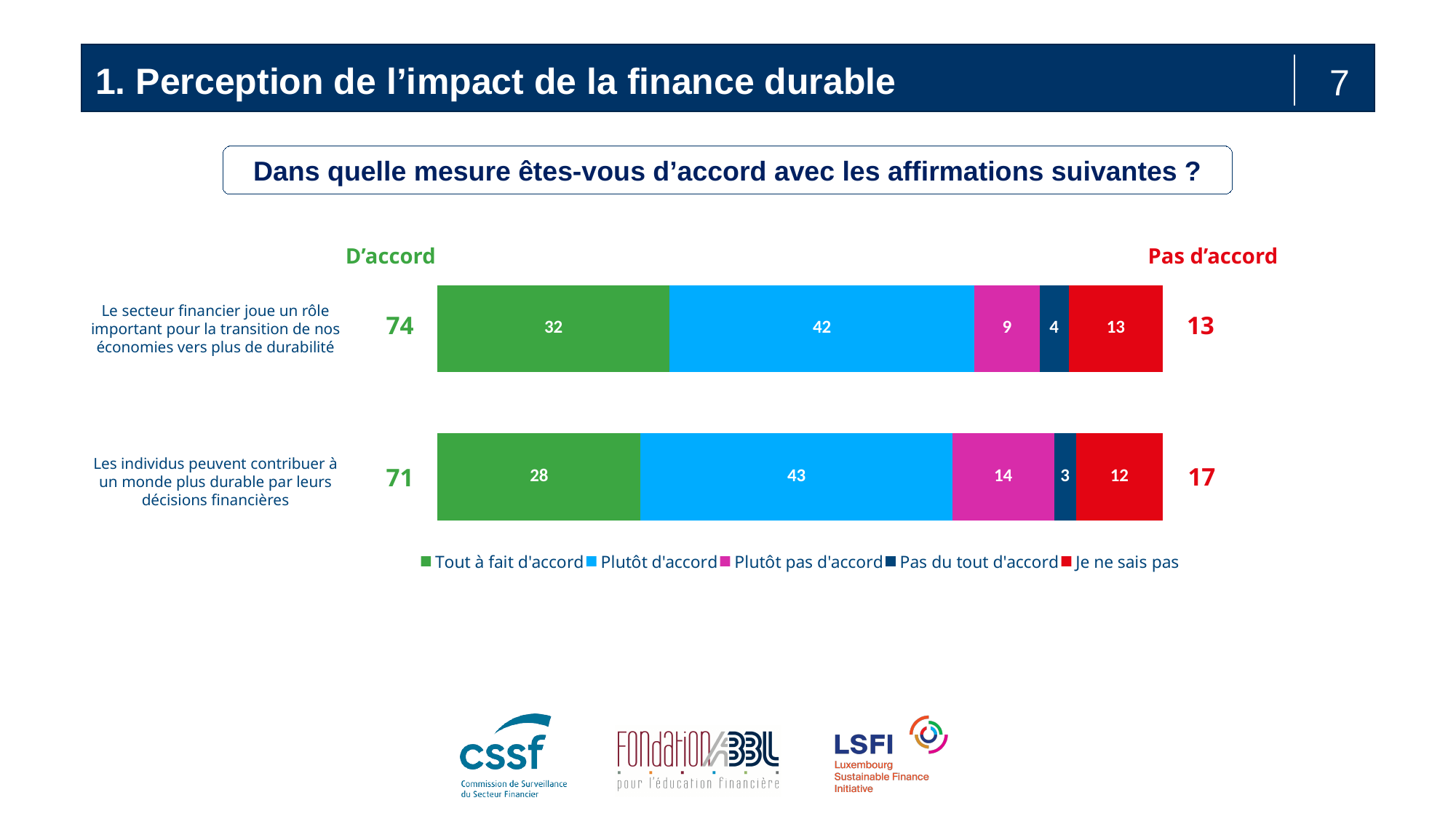
How many series does the legend list? 5 What is the combined "D'accord" total shown for the statement "Le secteur financier joue un rôle important pour la transition de nos économies vers plus de durabilité"? 74 Which colour represents "Je ne sais pas" in the chart? Red What is the combined "Pas d'accord" total shown for the statement "Les individus peuvent contribuer à un monde plus durable par leurs décisions financières"? 17 What is the value for "Je ne sais pas" for the statement "Le secteur financier joue un rôle important pour la transition de nos économies vers plus de durabilité"? 13 What is the value for "Pas du tout d'accord" for the statement "Les individus peuvent contribuer à un monde plus durable par leurs décisions financières"? 3 What is the difference between the "Tout à fait d'accord" values of the two statements? 4 How many statements (categories) are plotted in the chart? 2 What kind of chart is shown on the slide? Stacked bar chart What is the value for "Tout à fait d'accord" for the statement "Le secteur financier joue un rôle important pour la transition de nos économies vers plus de durabilité"? 32 What is the value for "Plutôt d'accord" for the statement "Les individus peuvent contribuer à un monde plus durable par leurs décisions financières"? 43 Which statement has the higher "Plutôt pas d'accord" value? Les individus peuvent contribuer à un monde plus durable par leurs décisions financières